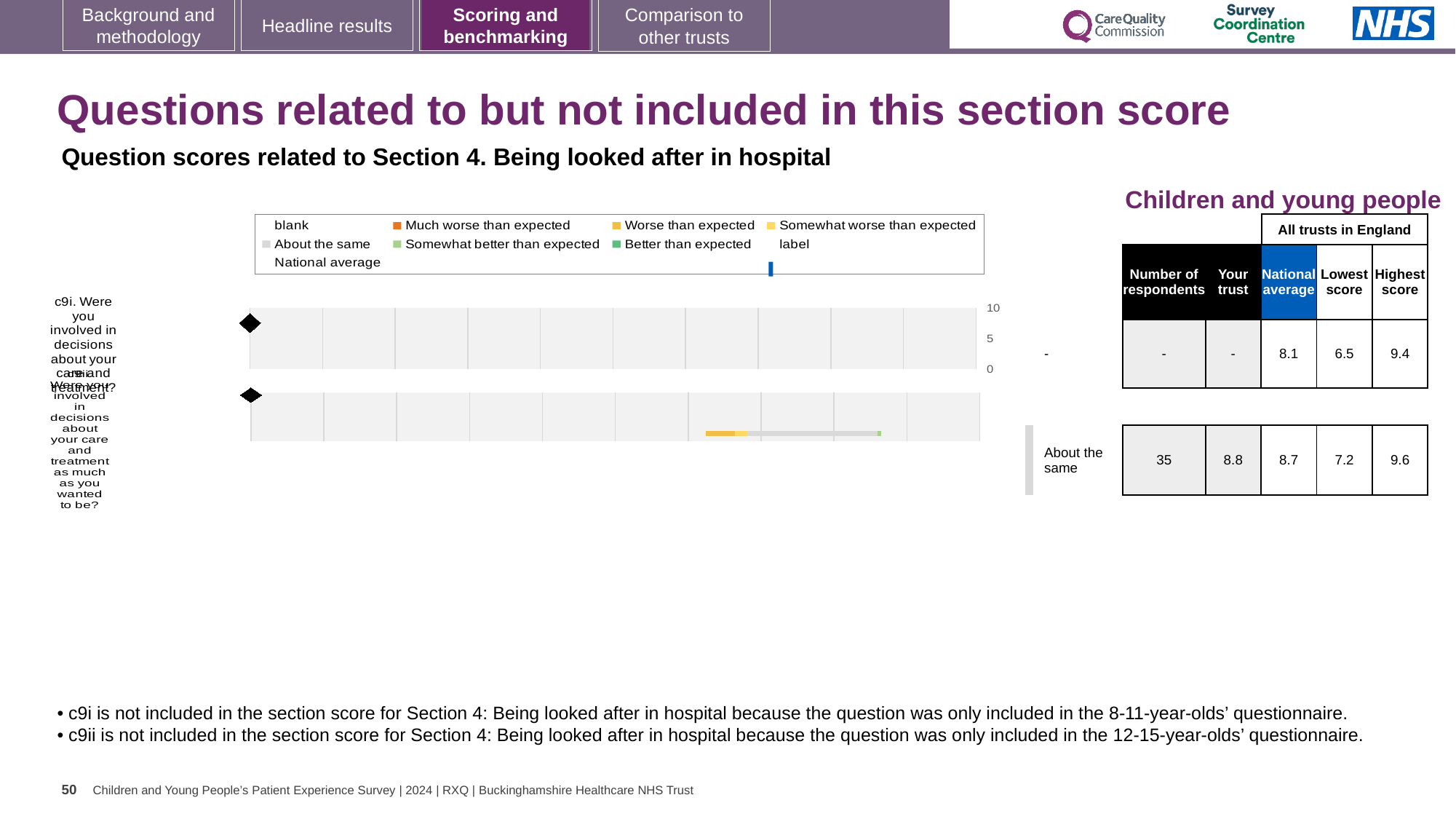
What is the national average score for question c9i? 8.1 What is the highest value shown on the chart's axis? 10 What is the highest score among all trusts in England for question c9ii? 9.6 What benchmark category is shown for question c9ii? About the same How many questions (rows) are plotted in the chart? 2 What kind of chart is shown on the slide? bar chart What is the number of respondents for question c9ii? 35 What is the difference between the highest and lowest scores among all trusts in England for question c9ii? 2.4 Which is larger for question c9ii: the trust's score or the national average? the trust's score What is the national average score for question c9ii? 8.7 What is the lowest score among all trusts in England for question c9i? 6.5 What is the 'Your trust' score for question c9ii? 8.8